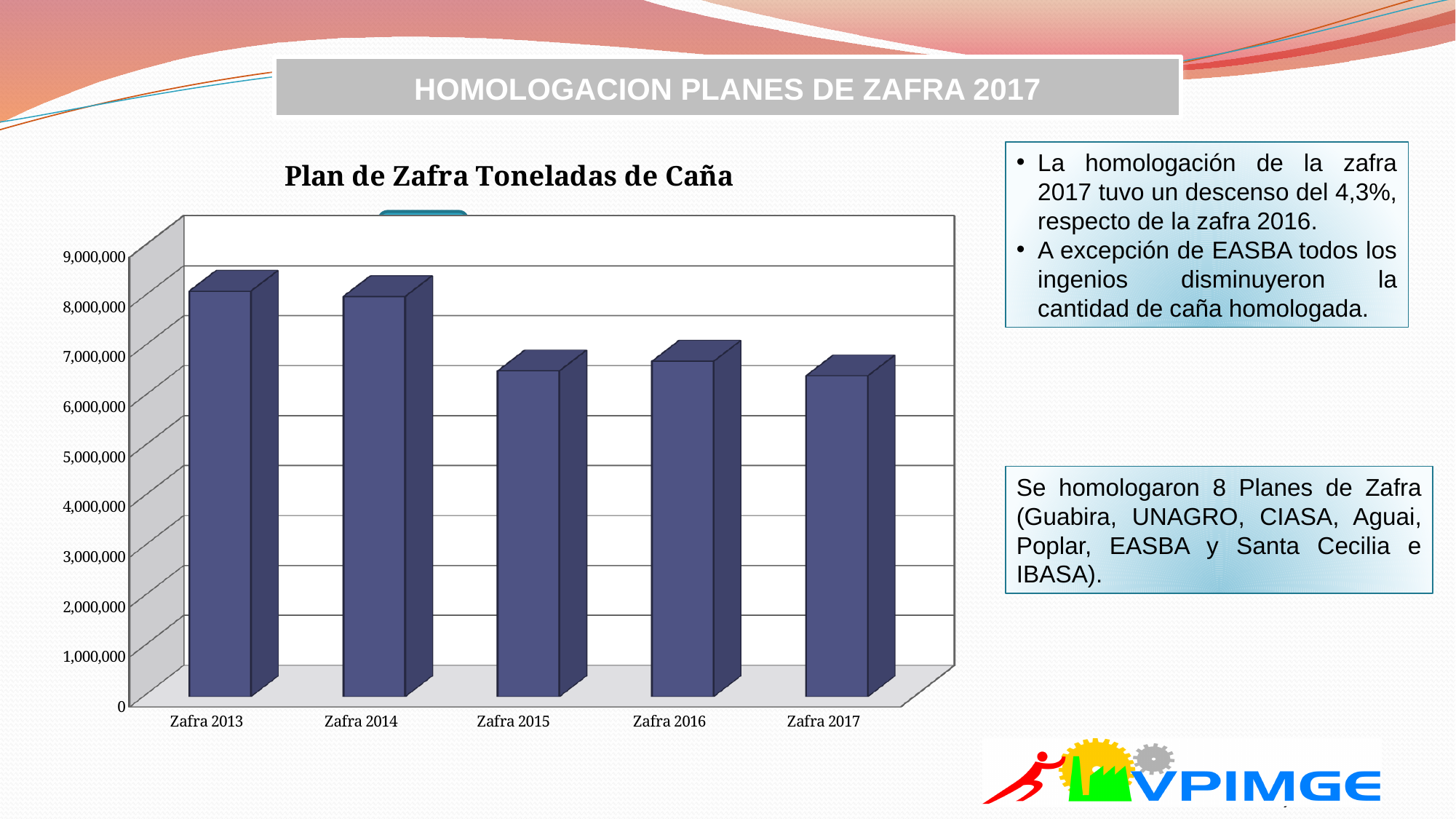
Which is larger, the value for Zafra 2014 or Zafra 2017? Zafra 2014 Which is larger, the value for Zafra 2013 or Zafra 2015? Zafra 2013 What is the title of the chart? Plan de Zafra Toneladas de Caña Is the value for Zafra 2017 greater or less than 7,000,000? less How many zafra years (categories) are plotted in the chart? 5 Is the value for Zafra 2017 greater or less than 6,000,000? greater Do the values generally rise or fall from Zafra 2013 to Zafra 2017? fall Which category is the first one on the x axis? Zafra 2013 What type of chart is shown on the slide? bar chart Is the value for Zafra 2015 greater or less than 7,000,000? less